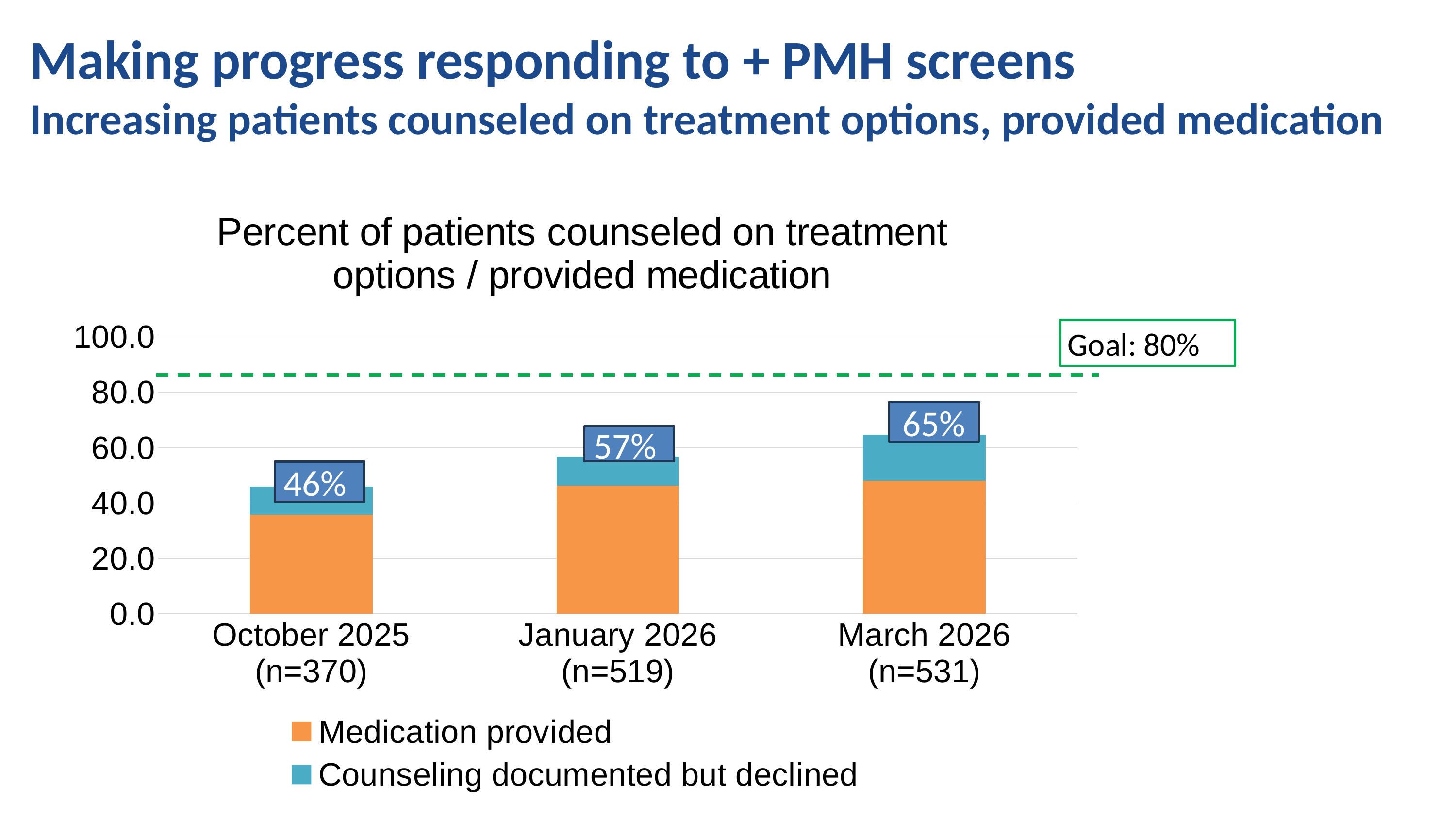
How many series does the chart legend list? 2 How many time periods are shown on the x axis of the chart? 3 Is the Medication provided value for March 2026 greater or less than 40.0? greater What is the difference between the total percent for March 2026 and the total percent for October 2025? 19% What goal value is marked by the dashed line on the chart? Goal: 80% Which time period has the lowest total percent of patients counseled on treatment options / provided medication? October 2025 (n=370) Which time period has the highest total percent of patients counseled on treatment options / provided medication? March 2026 (n=531) What is the total percent shown for January 2026 (n=519)? 57% What is the total percent shown for October 2025 (n=370)? 46% What kind of chart is shown on the slide? Stacked bar chart What is the total percent shown for March 2026 (n=531)? 65% Which is larger, the total percent for January 2026 or the total percent for October 2025? January 2026